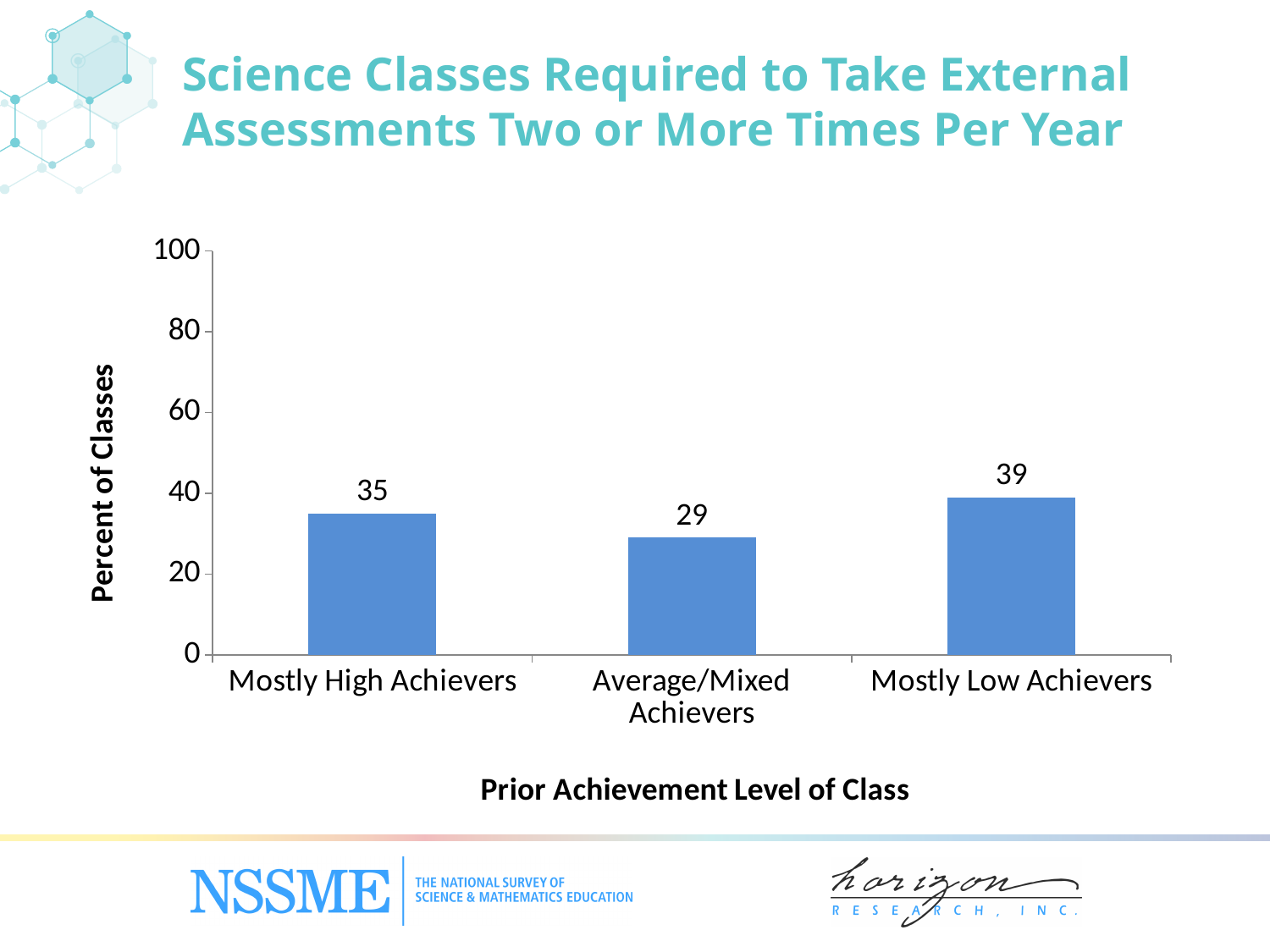
Which category has the lowest value? Average/Mixed Achievers How many categories are shown on the x axis? 3 Which is larger, the value for Mostly High Achievers or the value for Mostly Low Achievers? Mostly Low Achievers What is the value for Average/Mixed Achievers? 29 What is the value for Mostly High Achievers? 35 What is the label of the y axis? Percent of Classes Is the value for Mostly Low Achievers greater or less than 20? greater What is the difference between the values for Mostly High Achievers and Average/Mixed Achievers? 6 What kind of chart is shown on the slide? bar chart What is the value for Mostly Low Achievers? 39 What is the difference between the values for Mostly Low Achievers and Average/Mixed Achievers? 10 Which category has the highest value? Mostly Low Achievers